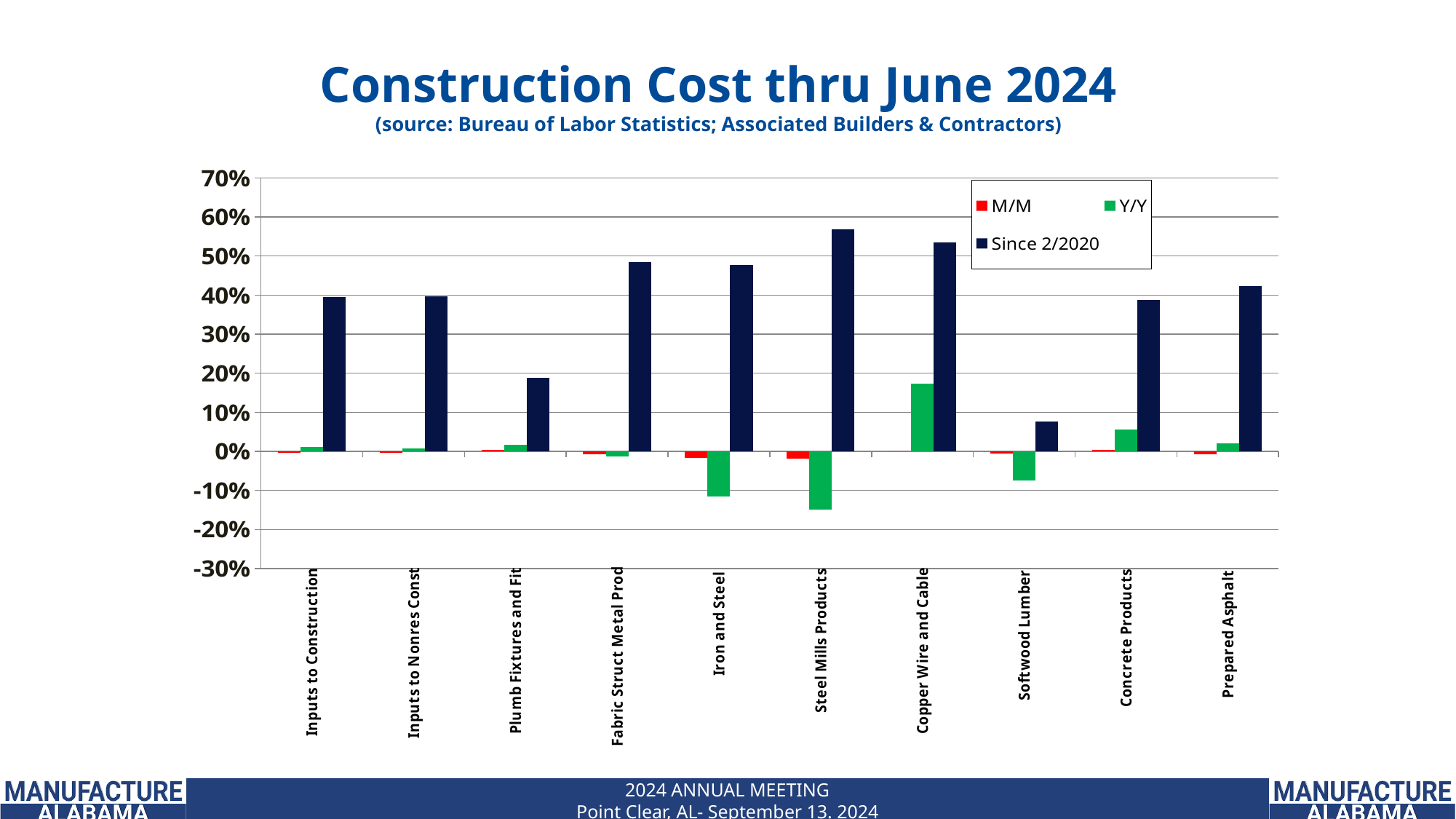
Is the Since 2/2020 value for Plumb Fixtures and Fit greater or less than 20%? less What kind of chart is shown on the slide? bar chart What is the title of the chart? Construction Cost thru June 2024 Is the Y/Y value for Copper Wire and Cable greater or less than 10%? greater Which category has the lowest Y/Y value? Steel Mills Products How many series does the legend list? 3 Which category has the highest Since 2/2020 value? Steel Mills Products Is the Since 2/2020 value for Steel Mills Products greater or less than 50%? greater Which category has the lowest Since 2/2020 value? Softwood Lumber How many categories are shown on the x axis? 10 Which is larger, the Y/Y value for Copper Wire and Cable or the Y/Y value for Concrete Products? Copper Wire and Cable Which category has the highest Y/Y value? Copper Wire and Cable